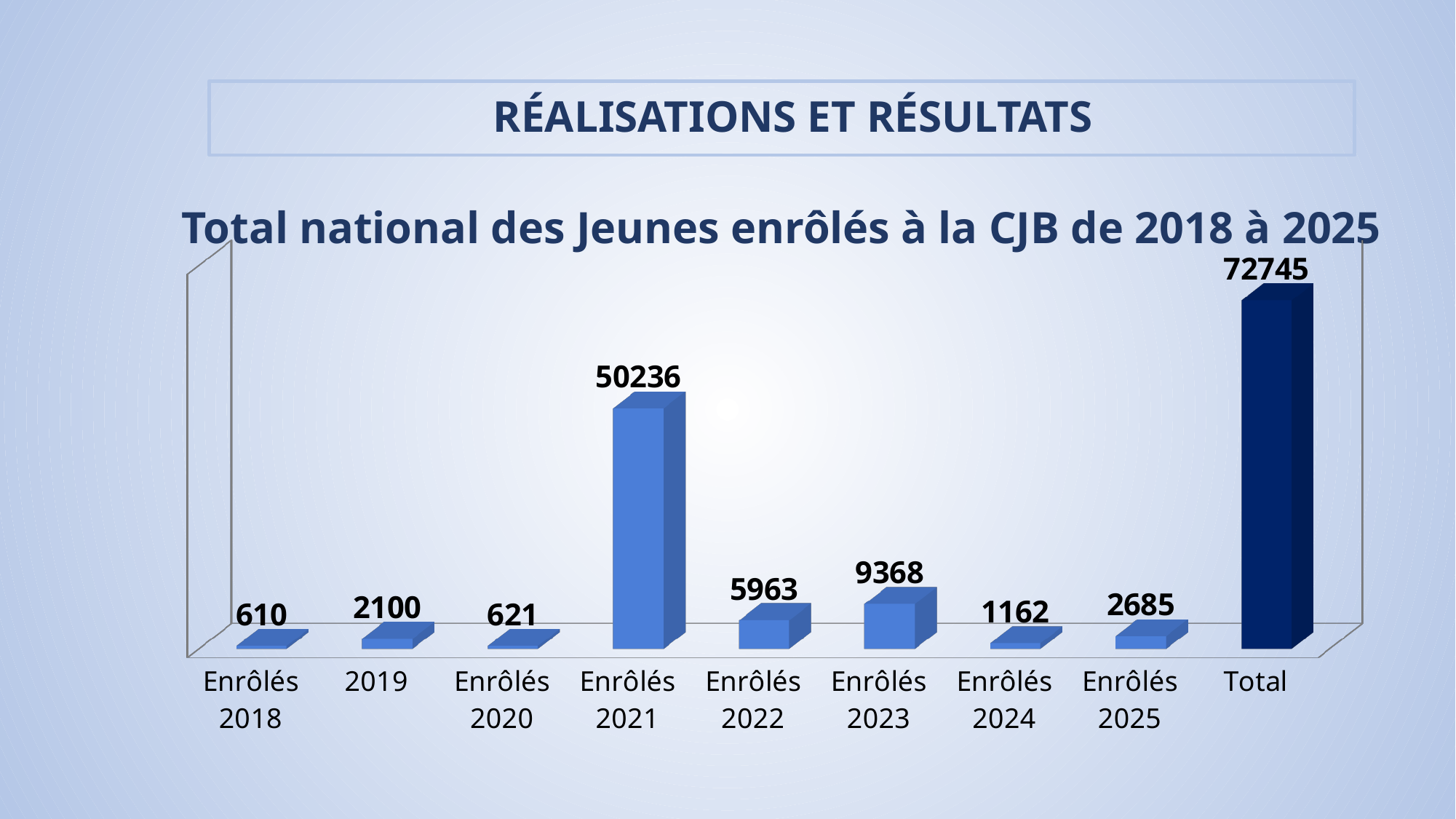
What is the difference between the values for Enrôlés 2023 and Enrôlés 2022? 3405 Which is larger, the value for Enrôlés 2025 or Enrôlés 2019? Enrôlés 2025 What is the difference between the value for Enrôlés 2020 and Enrôlés 2018? 11 What is the value for Enrôlés 2018? 610 What is the value for Enrôlés 2024? 1162 Excluding the Total bar, which year has the highest number of enrolled youth? Enrôlés 2021 What is the value for Enrôlés 2021? 50236 How many bars are plotted in the chart? 9 What kind of chart is shown on the slide? Bar chart What is the value shown for the Total bar? 72745 Which category has the lowest value? Enrôlés 2018 What is the title of the chart? Total national des Jeunes enrôlés à la CJB de 2018 à 2025